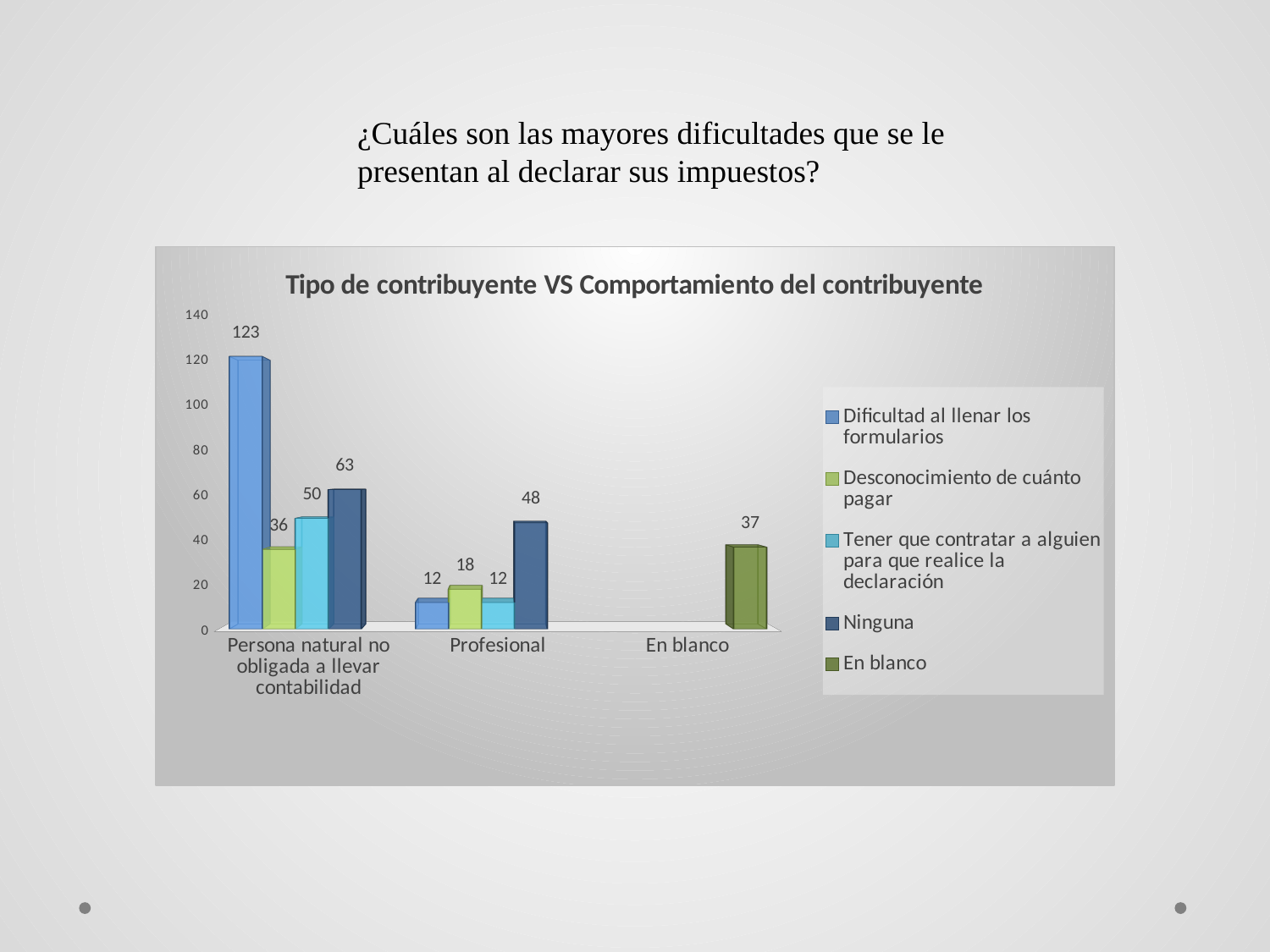
Is the value for 'Dificultad al llenar los formularios' in the 'Persona natural no obligada a llevar contabilidad' category greater or less than 100? greater Which series has the lowest value in the 'Persona natural no obligada a llevar contabilidad' category? Desconocimiento de cuánto pagar What is the value for 'Ninguna' in the 'Profesional' category? 48 What is the value for 'Desconocimiento de cuánto pagar' in the 'Profesional' category? 18 Which is larger: 'Ninguna' for 'Profesional' or 'En blanco' for 'En blanco'? Ninguna for Profesional How many series does the legend list? 5 Which series has the highest value in the 'Persona natural no obligada a llevar contabilidad' category? Dificultad al llenar los formularios What is the value for 'Dificultad al llenar los formularios' in the 'Persona natural no obligada a llevar contabilidad' category? 123 How many categories are shown on the x axis? 3 What is the difference between 'Ninguna' and 'Tener que contratar a alguien para que realice la declaración' in the 'Persona natural no obligada a llevar contabilidad' category? 13 What is the value for 'En blanco' in the 'En blanco' category? 37 What kind of chart is shown on the slide? Bar chart